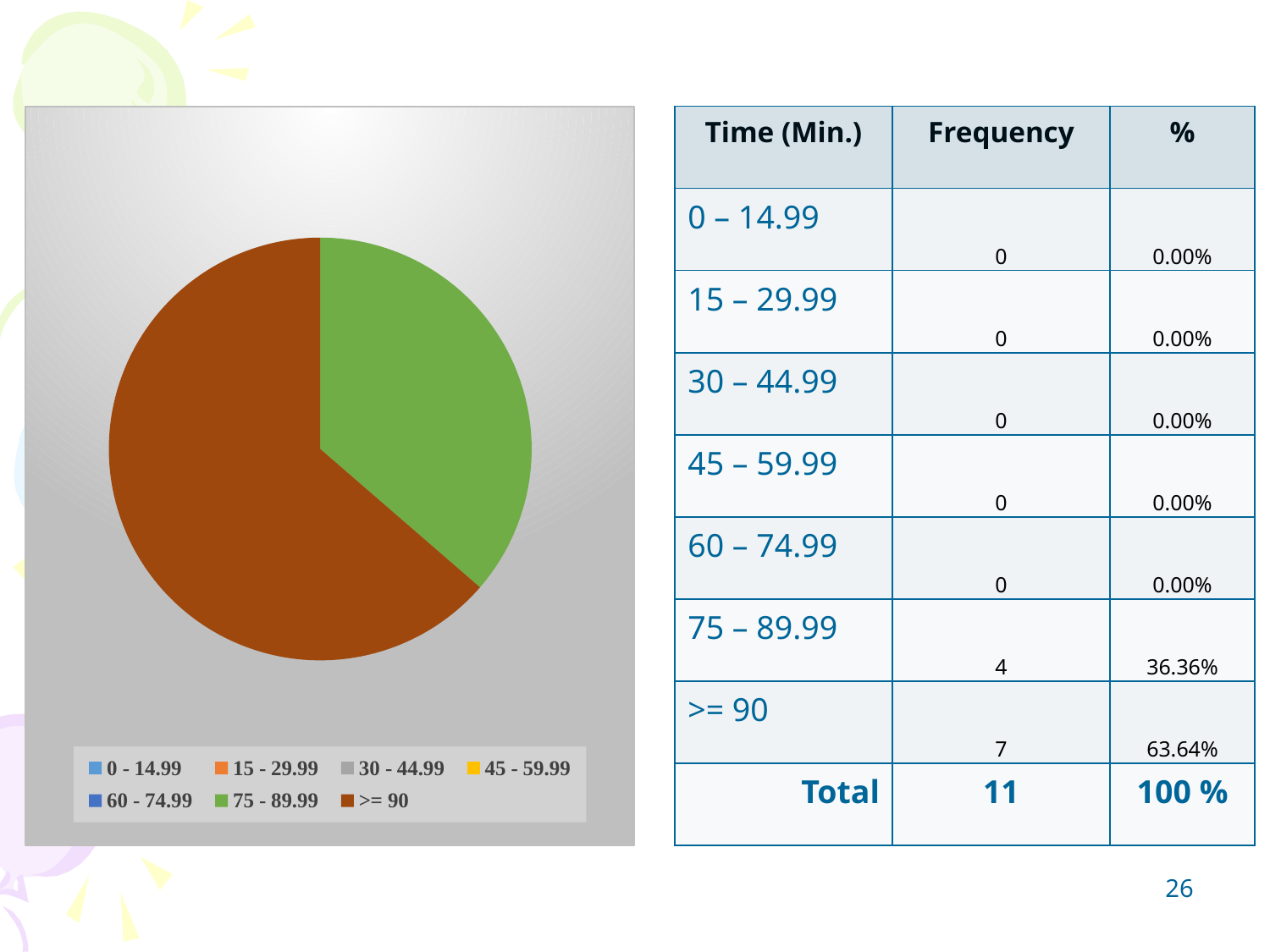
What share of the pie does the 75 - 89.99 category take, according to the table? 36.36% What kind of chart is shown on the left of the slide? pie chart What share of the pie does the >= 90 category take, according to the table? 63.64% Which of the two visible slices is larger, 75 - 89.99 or >= 90? >= 90 What is the frequency for the >= 90 category? 7 What colour is the >= 90 slice in the pie chart? brown Which category has the largest slice in the pie chart? >= 90 What is the frequency for the 75 - 89.99 category? 4 How many slices are visible in the pie chart? 2 What is the total frequency across all categories? 11 What is the difference in frequency between the >= 90 and 75 - 89.99 categories? 3 How many categories does the pie chart's legend list? 7